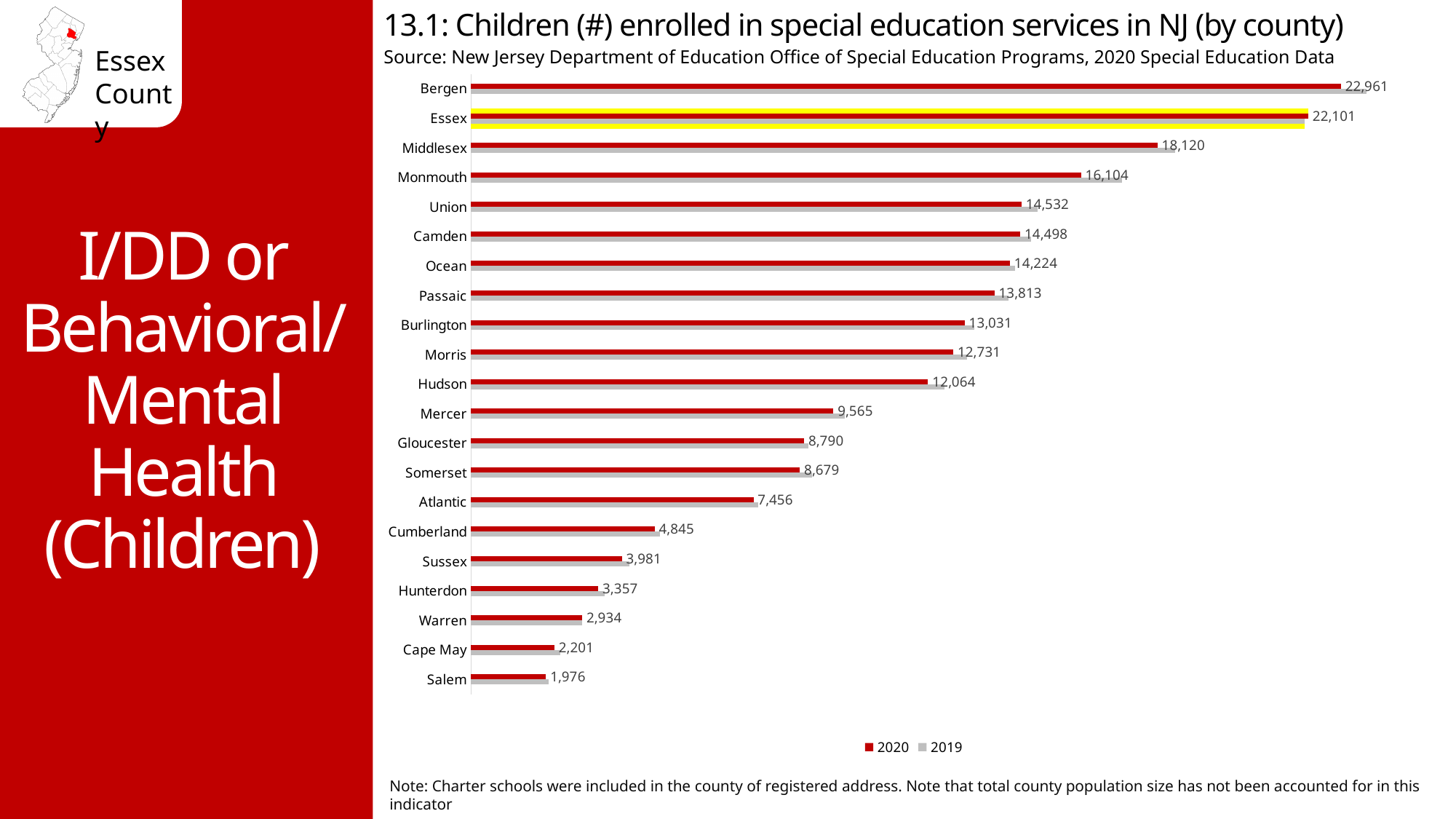
What is the 2020 value for Essex? 22,101 How many counties are shown in the chart? 21 Which series is shown in red in the legend? 2020 Which county has the highest number of children enrolled in special education services in 2020? Bergen What is the 2020 value for Middlesex? 18,120 How many series does the legend list? 2 What is the 2020 value for Cape May? 2,201 Which county has a larger 2020 value, Hudson or Mercer? Hudson What kind of chart is shown on the slide? bar chart What is the source cited for the chart? New Jersey Department of Education Office of Special Education Programs, 2020 Special Education Data What is the difference between the 2020 values for Bergen and Essex? 860 Which county has the lowest number of children enrolled in special education services in 2020? Salem